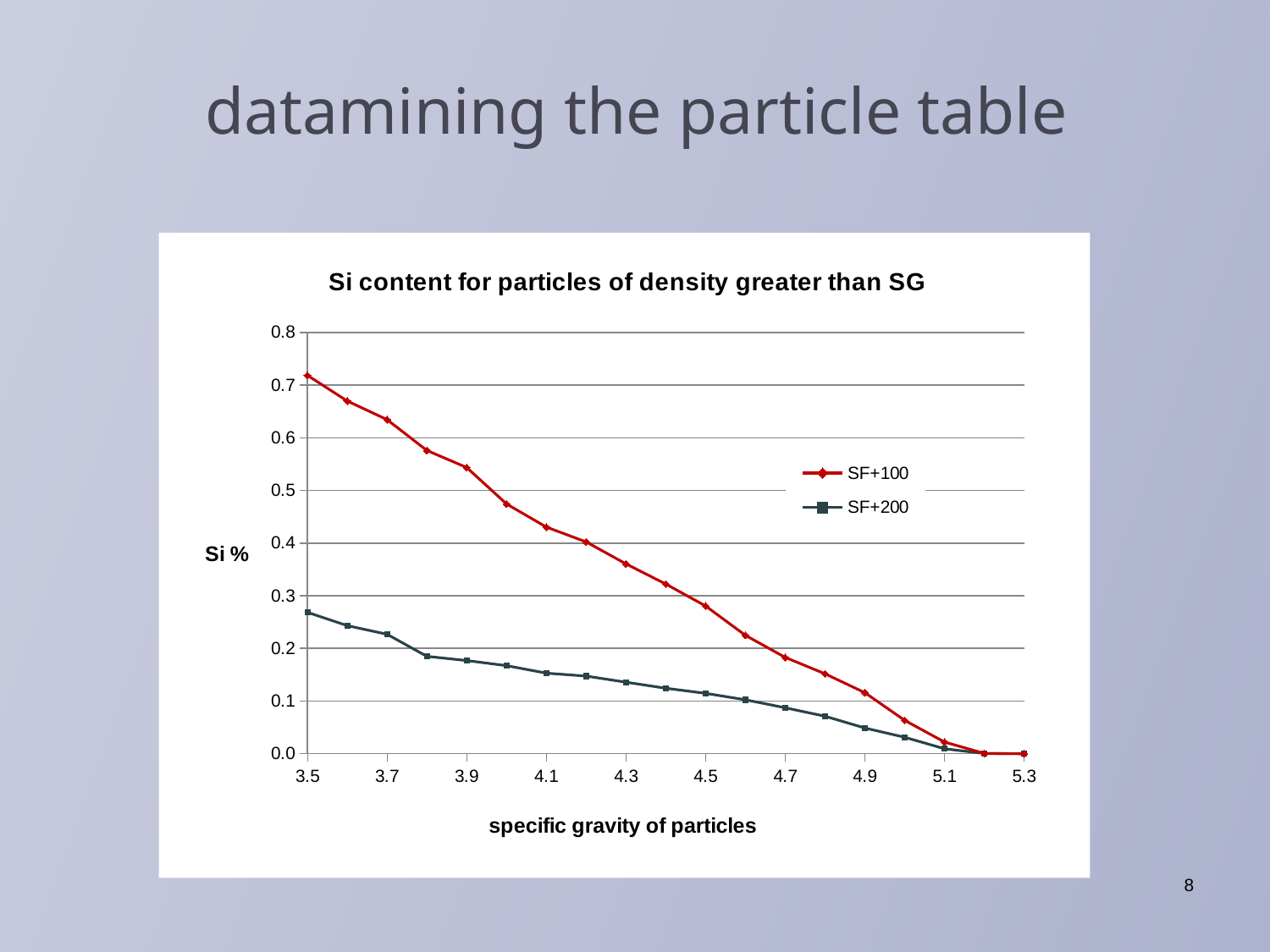
How many series does the legend list? 2 What are the names of the two series in the legend? SF+100 and SF+200 Is the SF+100 value at specific gravity 4.1 greater or less than 0.4? greater Is the SF+200 value at specific gravity 3.5 greater or less than 0.2? greater Is the SF+200 value at specific gravity 4.7 greater or less than 0.1? less At a specific gravity of 3.5, which series has the larger Si % value, SF+100 or SF+200? SF+100 What kind of chart is shown on the slide? line chart Do the SF+100 values rise or fall as specific gravity increases along the x axis? fall What is the title of the chart? Si content for particles of density greater than SG At which specific gravity is the SF+100 series highest? 3.5 Do the SF+200 values rise or fall as specific gravity increases along the x axis? fall